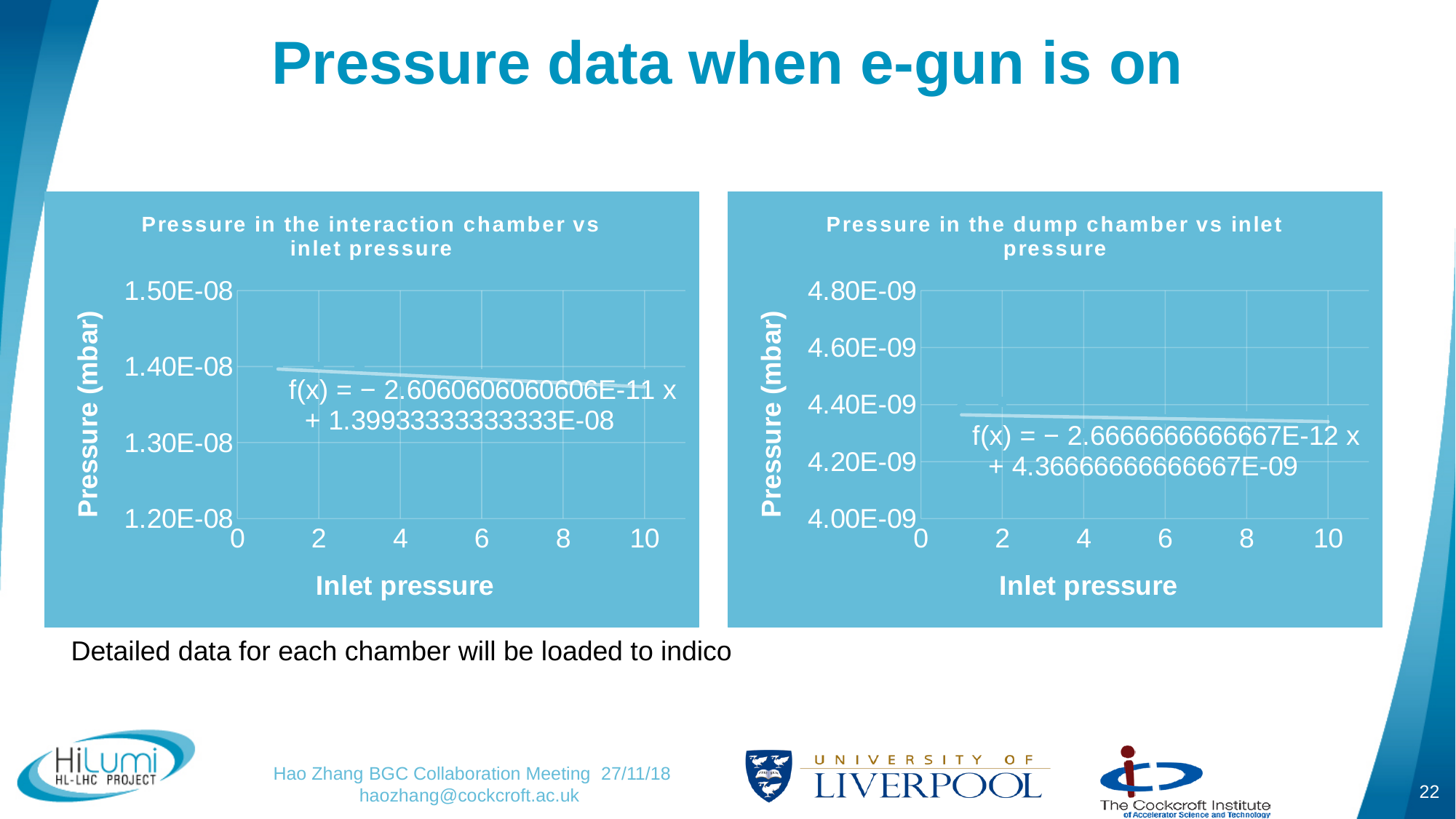
In the chart titled 'Pressure in the dump chamber vs inlet pressure', do the pressure values rise or fall as inlet pressure increases? fall In the chart on the left (interaction chamber), is the pressure at inlet pressure 10 greater or less than 1.40E-08? less In the chart titled 'Pressure in the interaction chamber vs inlet pressure', do the pressure values rise or fall as inlet pressure increases? fall In the chart on the right (dump chamber), is the pressure at inlet pressure 6 greater or less than 4.60E-09? less In the chart on the right (Pressure in the dump chamber vs inlet pressure), what is the label of the y axis? Pressure (mbar) In the chart on the left (interaction chamber), is the pressure at inlet pressure 2 greater or less than 1.30E-08? greater Which chamber shows higher pressure values, the interaction chamber (left chart) or the dump chamber (right chart)? interaction chamber What is the title of the chart on the left of the slide? Pressure in the interaction chamber vs inlet pressure